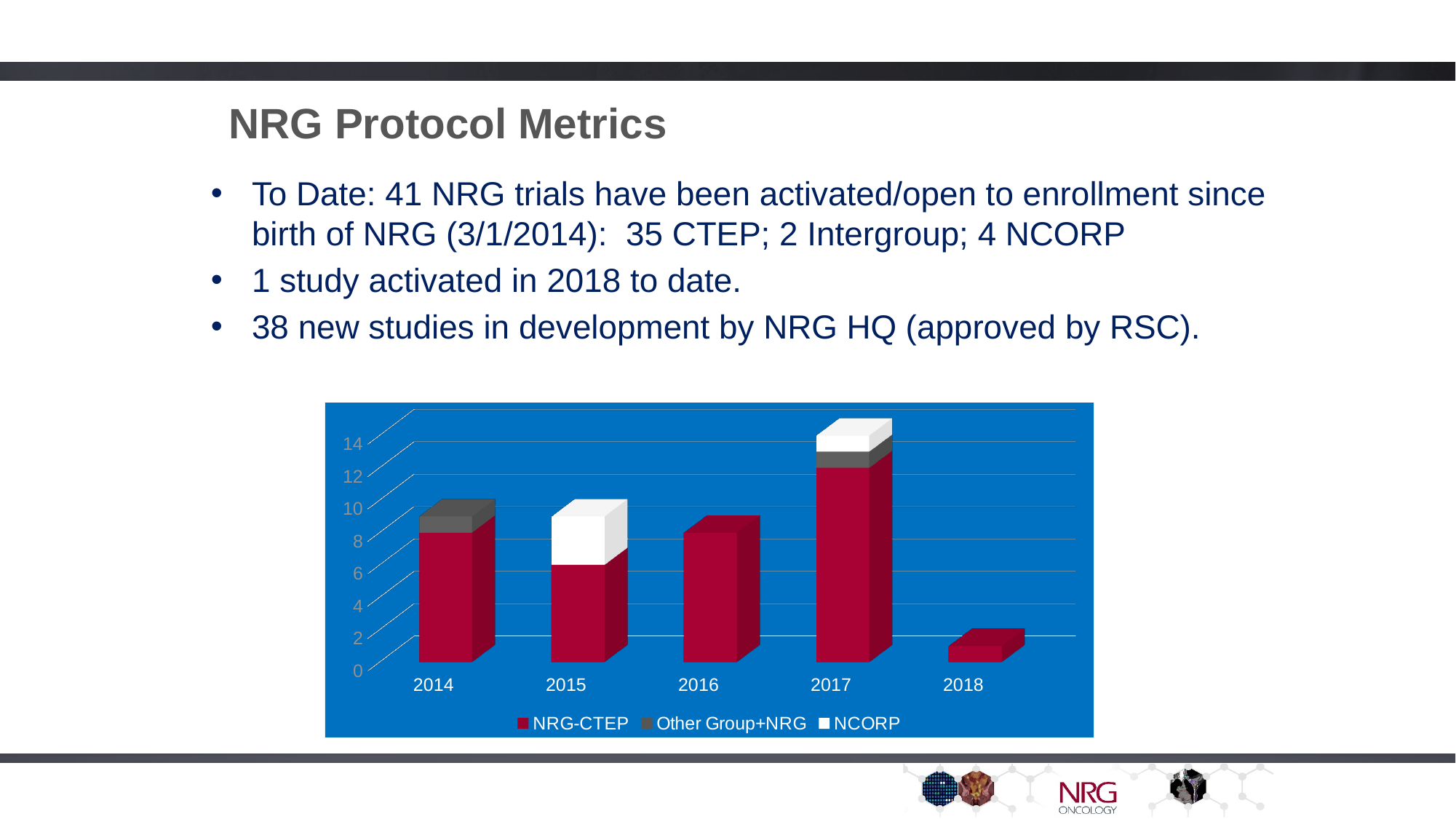
Which stacked bar is taller, 2016 or 2017? 2017 Which stacked bar is taller, 2014 or 2018? 2014 Which year has the shortest stacked bar in the chart? 2018 Which year has the tallest stacked bar in the chart? 2017 Is the value for 2018 greater or less than 4? less Does the stacked bar height rise or fall from 2017 to 2018? fall Which series is shown in red in the chart's legend? NRG-CTEP What kind of chart is shown on the slide? bar chart Is the total stacked bar for 2017 greater or less than 10? greater How many years are shown on the x axis of the chart? 5 Is the NRG-CTEP value for 2016 greater or less than 4? greater How many series does the chart's legend list? 3